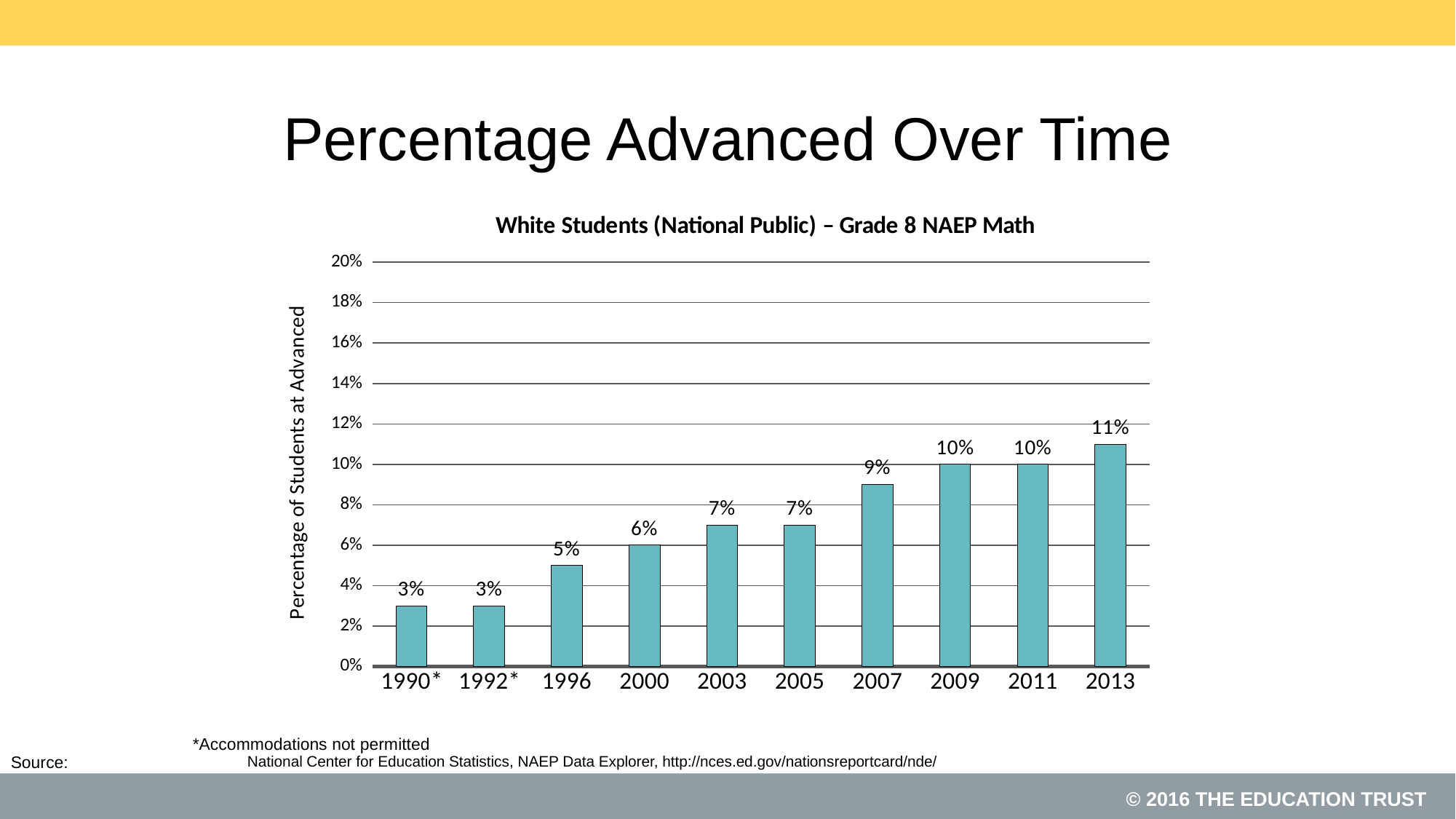
What is the label on the y axis of the chart? Percentage of Students at Advanced Which year has the highest percentage of students at Advanced? 2013 Do the values generally rise or fall from 1990* to 2013? Rise Is the value for 2011 greater or less than 8%? greater How many years are shown on the x axis of the chart? 10 What percentage of white students were at Advanced in 2013? 11% What percentage of white students were at Advanced in 2000? 6% What percentage of white students were at Advanced in 2007? 9% Which is larger, the value for 2009 or the value for 2005? 2009 What is the difference between the percentage at Advanced in 2013 and in 1990*? 8% What kind of chart is shown on the slide? Bar chart What is the title of the chart? White Students (National Public) – Grade 8 NAEP Math